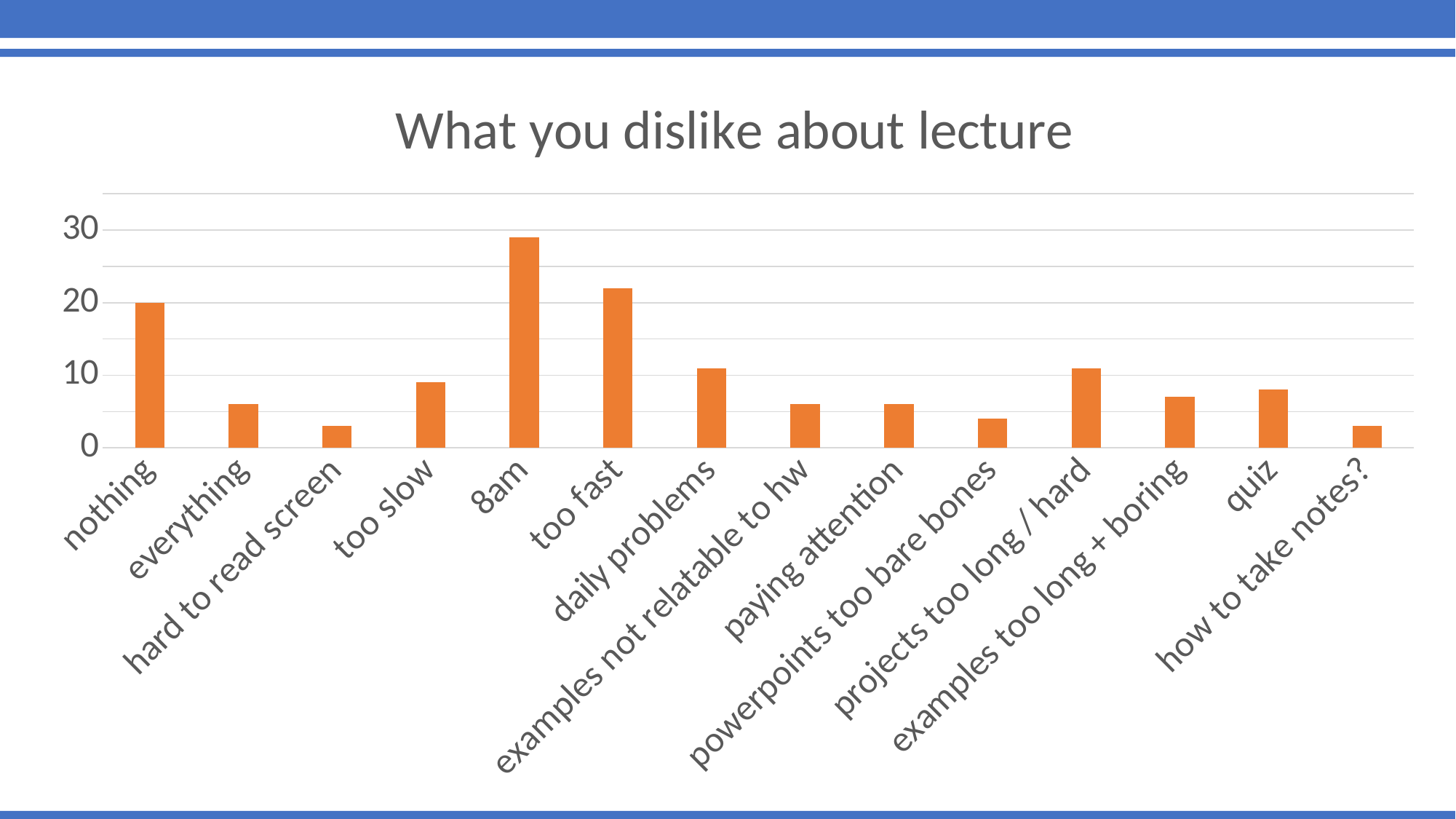
Which category has the highest value? 8am Which has a larger value, "8am" or "too fast"? 8am Is the value for "too fast" greater or less than 20? greater What is the value for "nothing"? 20 How many categories are shown on the x axis of the chart? 14 Which has a larger value, "quiz" or "too fast"? too fast What kind of chart is shown on the slide? bar chart Is the value for "powerpoints too bare bones" greater or less than 10? less Is the value for "everything" greater or less than 10? less Which has a larger value, "nothing" or "everything"? nothing What is the title of the chart? What you dislike about lecture